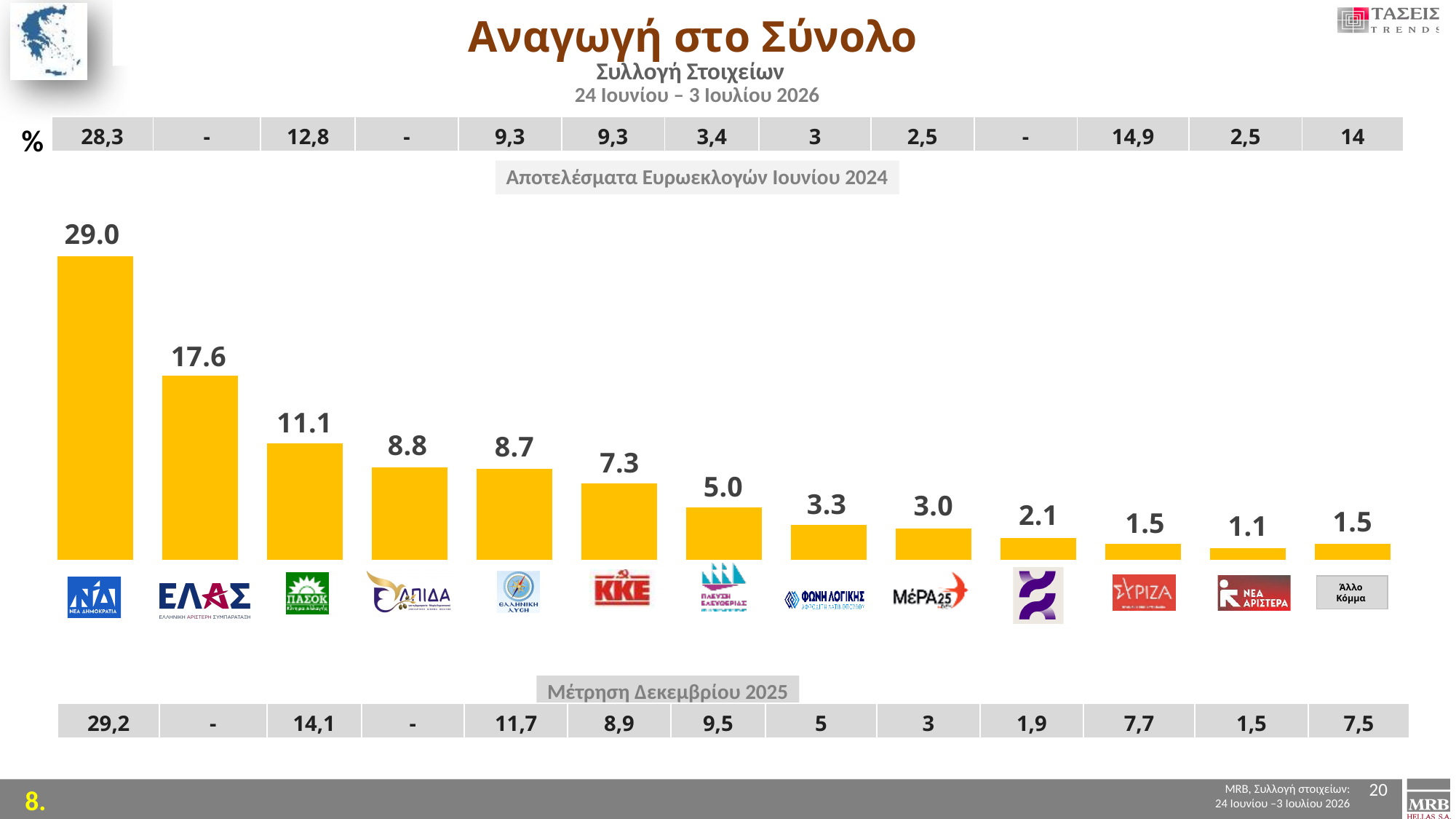
What is the value shown for ΚΚΕ in the bar chart? 7.3 Which has the larger value in the bar chart, ΚΚΕ or Πλεύση Ελευθερίας? ΚΚΕ What kind of chart is shown on the slide? Bar chart What is the main title of the slide? Αναγωγή στο Σύνολο What is the value shown for Φωνή Λογικής in the bar chart? 3.3 How many bars are shown in the chart? 13 What is the value shown for ΣΥΡΙΖΑ in the bar chart? 1.5 Which party has the highest bar in the chart? Νέα Δημοκρατία What is the difference between the values for ΠΑΣΟΚ and ΕΛΠΙΔΑ in the bar chart? 2.3 Which party has the lowest bar in the chart? Νέα Αριστερά What is the value shown for ΠΑΣΟΚ in the bar chart? 11.1 What is the difference between the values for Νέα Δημοκρατία and ΕΛΑΣ in the bar chart? 11.4